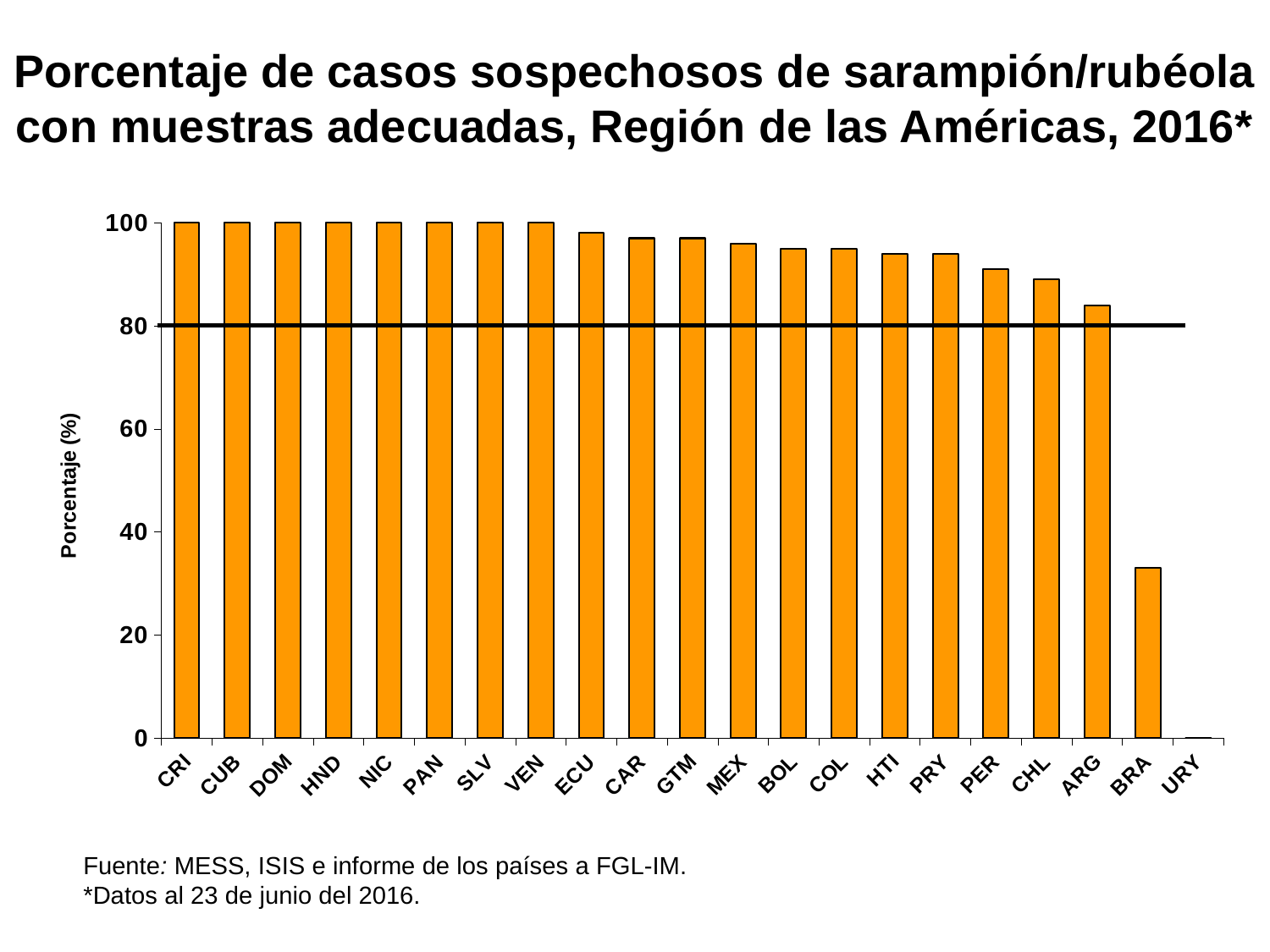
Is the value for URY greater or less than 20? less Is the value for ARG greater or less than 80? greater Is the value for CHL greater or less than 80? greater Do the values rise or fall moving from left to right along the x axis? fall What is the label of the y axis? Porcentaje (%) What kind of chart is shown on the slide? bar chart How many countries are shown on the x axis of the chart? 21 What is the value for VEN? 100 Which has the larger value, BRA or ARG? ARG Which country has the lowest value in the chart? URY What is the value for CRI? 100